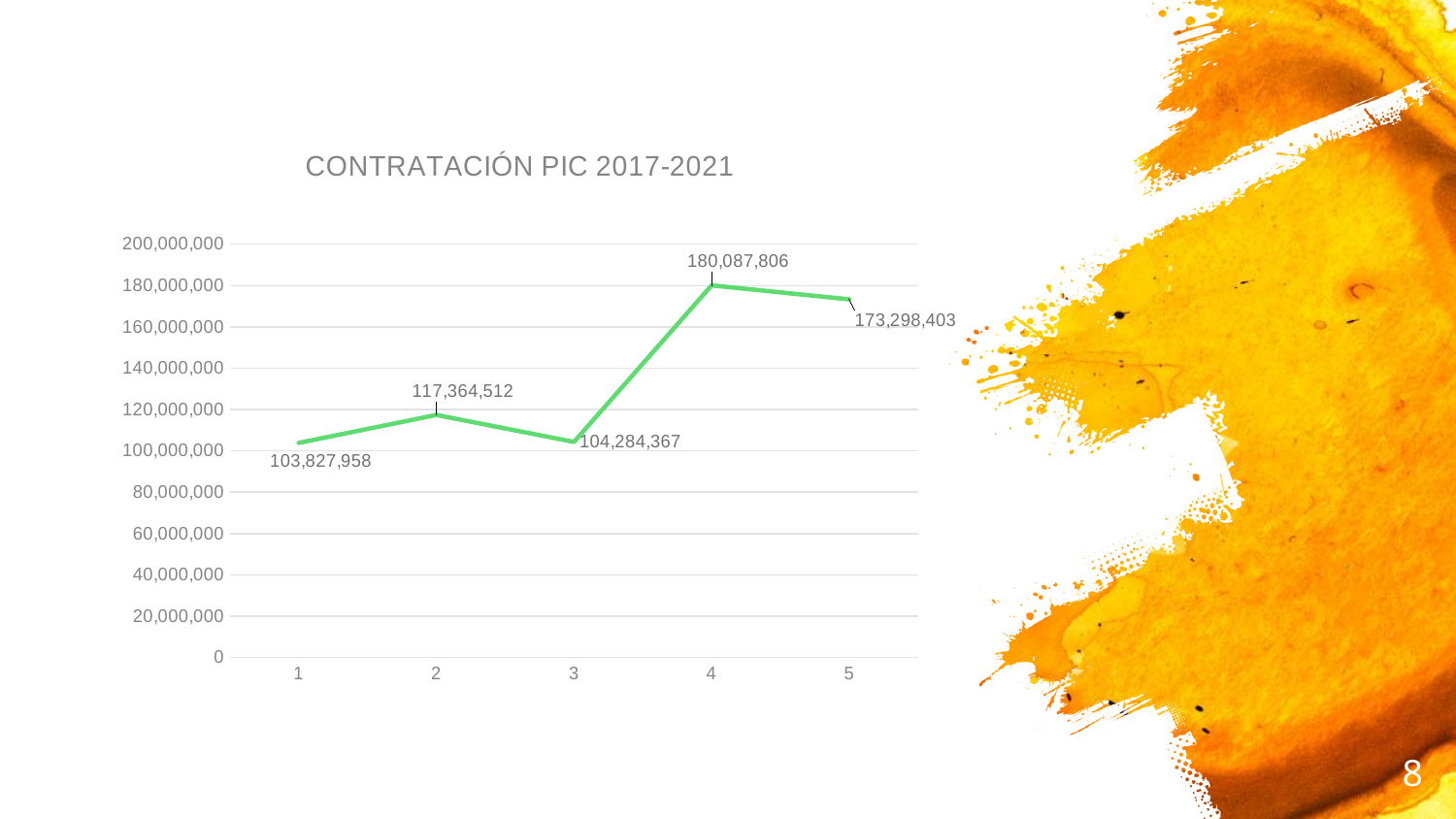
What is the value at point 1? 103,827,958 What is the value at point 5? 173,298,403 Which point has the highest value? 4 What is the title of the chart? CONTRATACIÓN PIC 2017-2021 How many data points are plotted on the line? 5 What kind of chart is shown on the slide? line chart What is the value at point 4? 180,087,806 What is the difference between the values at point 2 and point 1? 13,536,554 What is the difference between the values at point 4 and point 5? 6,789,403 Is the value at point 3 greater or less than 120,000,000? less Which point has the lowest value? 1 Which is larger, the value at point 2 or the value at point 3? point 2